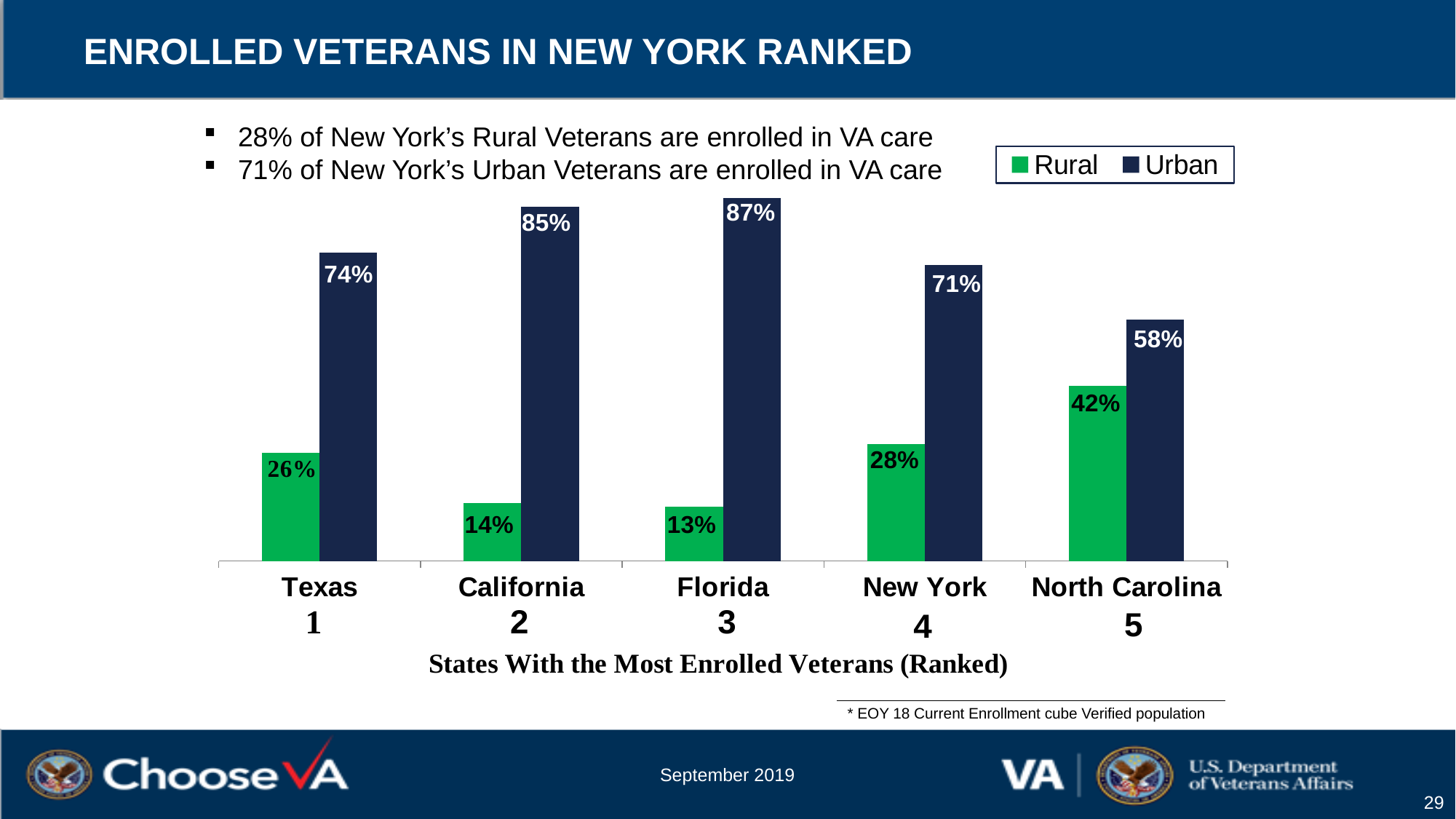
Which colour represents the Rural series in the legend? Green What is the Rural value for North Carolina? 42% What kind of chart is shown on the slide? Bar chart What is the difference between the Urban and Rural values for New York? 43% What is the Rural value for Texas? 26% How many series does the legend list? 2 What is the Urban value for Florida? 87% Which is larger, the Rural value for California or the Rural value for New York? New York Which state has the lowest Rural value? Florida What is the x-axis title of the chart? States With the Most Enrolled Veterans (Ranked) Which state has the highest Urban value? Florida How many states are shown on the x axis? 5